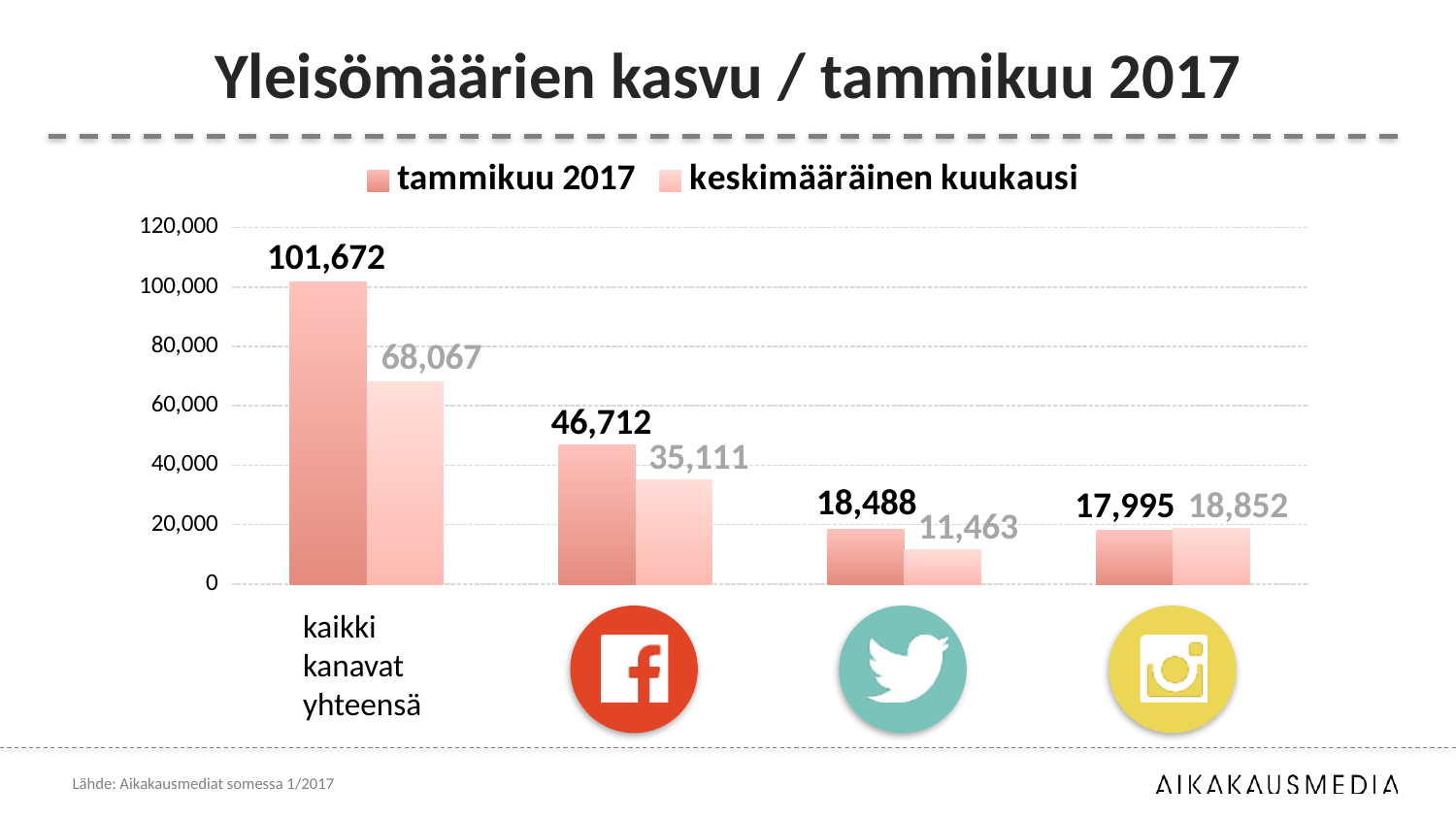
How many categories are shown on the x axis of the chart? 4 What kind of chart is shown on the slide? Bar chart What is the "keskimääräinen kuukausi" value for the Instagram category? 18,852 What is the "keskimääräinen kuukausi" value for the Facebook category? 35,111 Which category has the highest "keskimääräinen kuukausi" value? kaikki kanavat yhteensä How many series does the chart legend list? 2 What is the "tammikuu 2017" value for the Twitter category? 18,488 What is the value for "kaikki kanavat yhteensä" in the "tammikuu 2017" series? 101,672 Which category has the lowest "tammikuu 2017" value? Instagram For the Instagram category, which is larger: the "tammikuu 2017" value or the "keskimääräinen kuukausi" value? keskimääräinen kuukausi What is the title of the slide containing the chart? Yleisömäärien kasvu / tammikuu 2017 What is the difference between the "tammikuu 2017" and "keskimääräinen kuukausi" values for "kaikki kanavat yhteensä"? 33,605